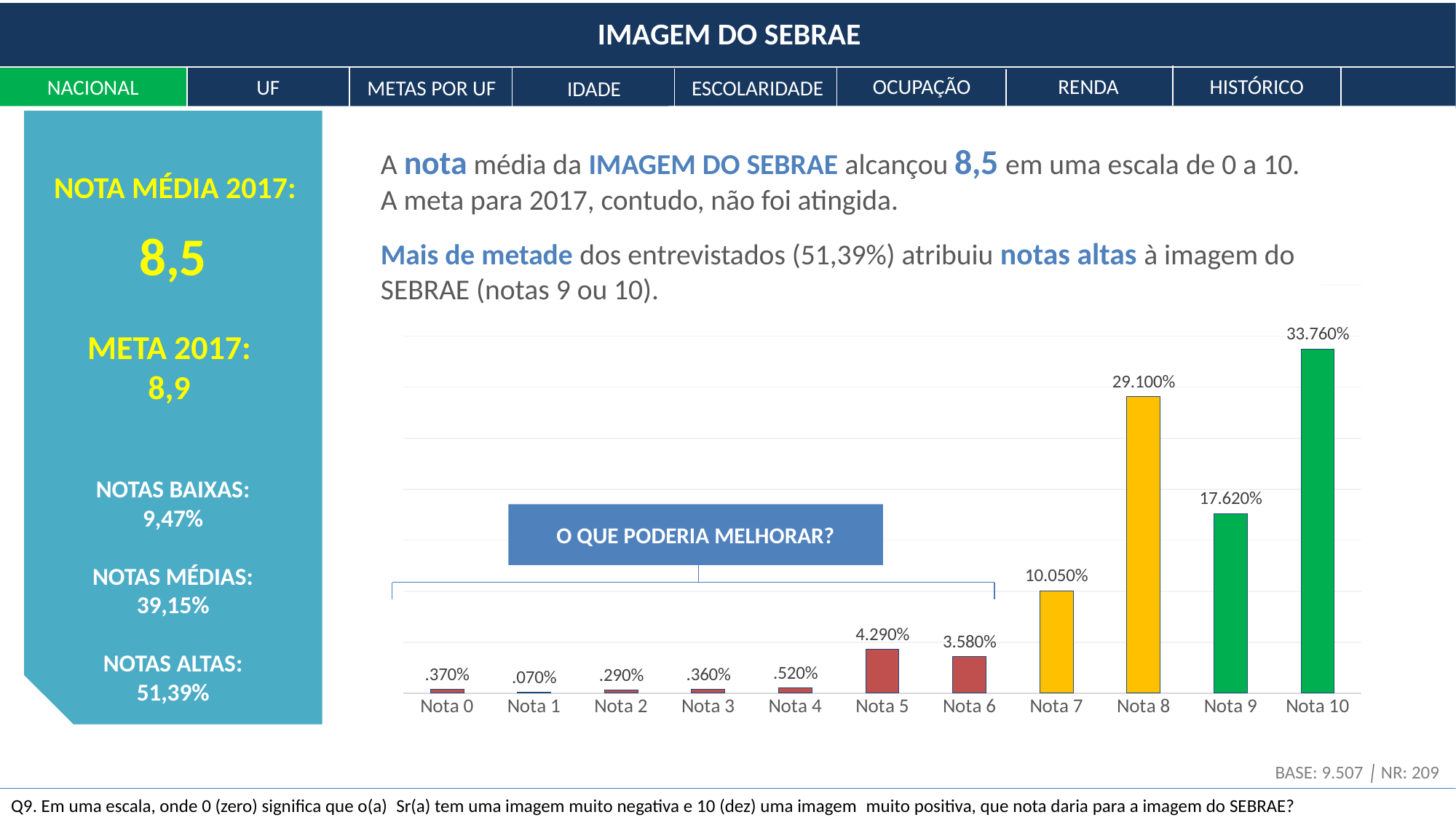
How many categories (notas) are shown on the x axis? 11 Which category has the lowest value? Nota 1 What is the difference between the values for Nota 8 and Nota 9? 11.480% What is the value for Nota 1? .070% What is the value for Nota 10? 33.760% What is the value for Nota 5? 4.290% What colour are the bars for Nota 9 and Nota 10? Green What is the difference between the values for Nota 10 and Nota 8? 4.660% Which category has the highest value? Nota 10 What kind of chart is shown on the slide? Bar chart What is the value for Nota 8? 29.100% Which is larger, the value for Nota 5 or the value for Nota 6? Nota 5